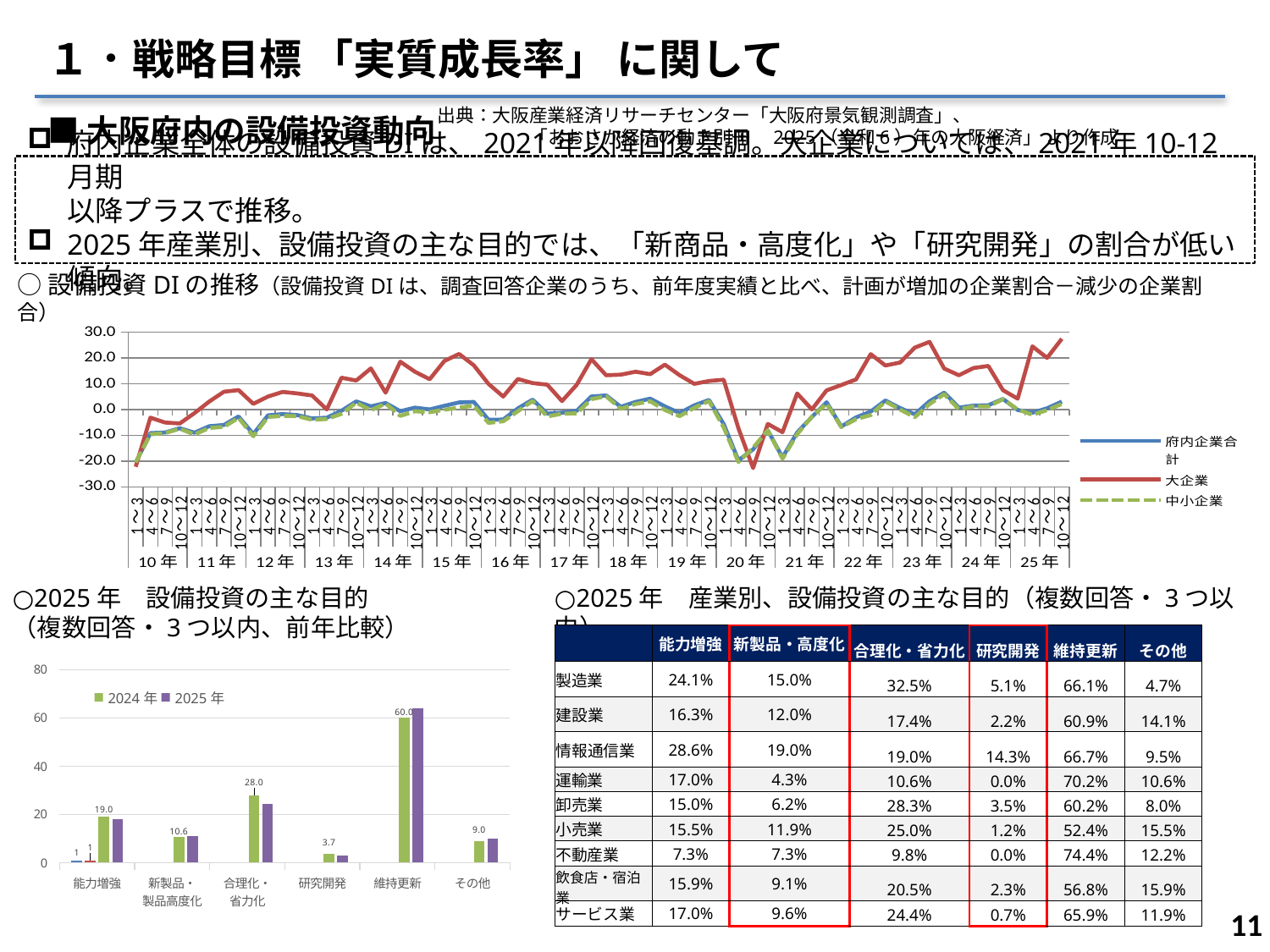
How many series does the legend of the 2025年 設備投資の主な目的 bar chart list? 2 In the 2025年 設備投資の主な目的 bar chart, which category has the highest value? 維持更新 How many series does the legend of the 設備投資DIの推移 line chart list? 3 In the 2025年 設備投資の主な目的 bar chart, is the 2025年 value for 合理化・省力化 greater or less than 40? less In the 2025年 設備投資の主な目的 bar chart, what is the labelled value for 維持更新 in the 2024年 series? 60.0 How many categories are shown on the x axis of the 2025年 設備投資の主な目的 bar chart? 6 In the 2025年 設備投資の主な目的 bar chart, what is the difference between the 2024年 values for 維持更新 and 合理化・省力化? 32.0 What kind of chart is the 設備投資DIの推移 chart in the middle of the slide? line chart In the 2025年 設備投資の主な目的 bar chart, what is the labelled value for 合理化・省力化 in the 2024年 series? 28.0 Which series are listed in the legend of the 設備投資DIの推移 line chart? 府内企業合計, 大企業, 中小企業 In the 2025年 設備投資の主な目的 bar chart, which category has the lowest value in the 2024年 series? 研究開発 What kind of chart is the 2025年 設備投資の主な目的 chart at the bottom left of the slide? bar chart